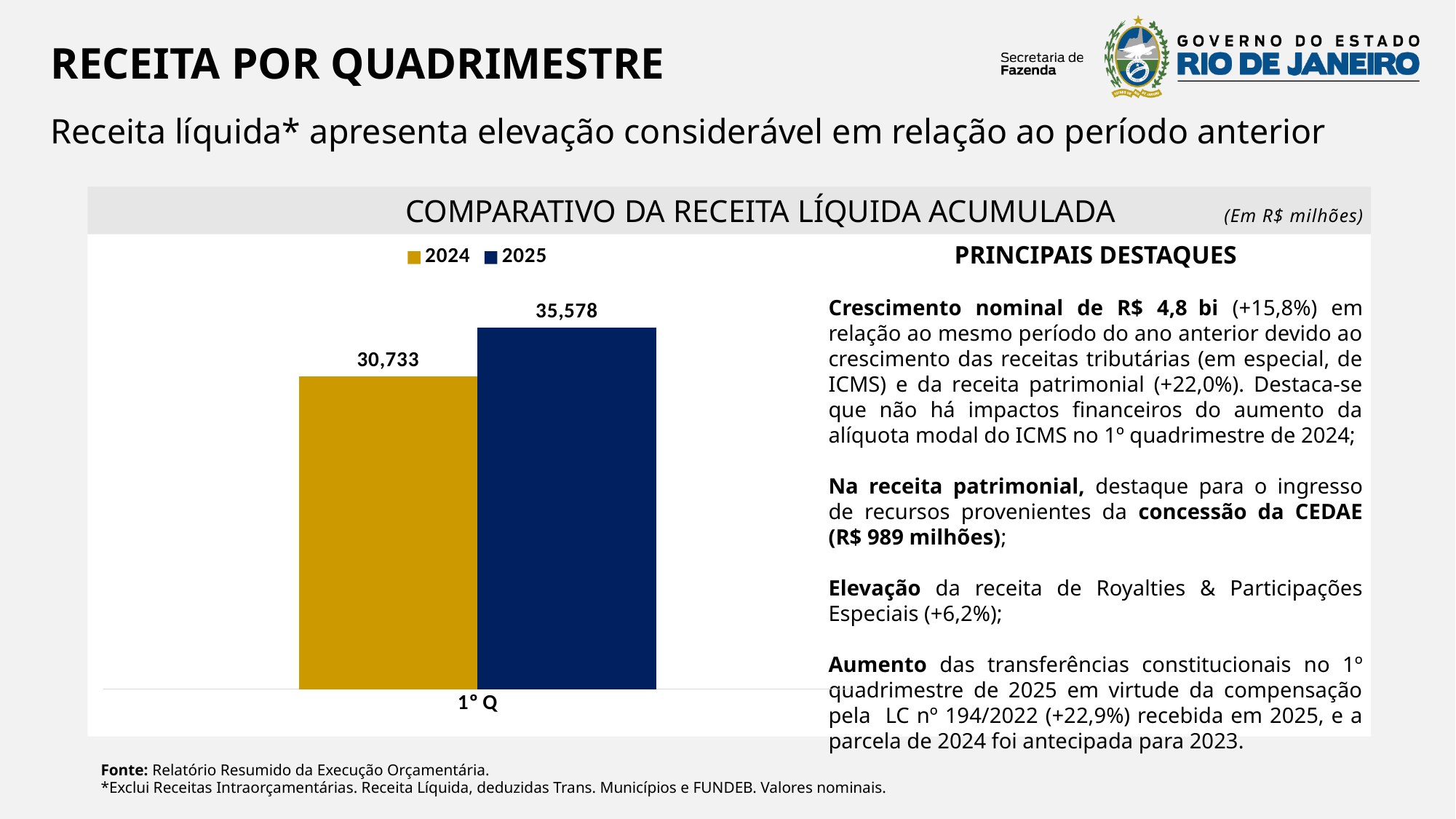
What is the difference between the 2025 and 2024 values for 1° Q? 4,845 What is the label of the category on the x axis? 1° Q In what unit are the chart values expressed? Em R$ milhões How many series does the chart legend list? 2 What is the value for 2025 in the 1° Q bar chart? 35,578 What kind of chart is shown on the slide? Bar chart How many categories are shown on the x axis of the chart? 1 What is the title of the chart? COMPARATIVO DA RECEITA LÍQUIDA ACUMULADA Which series shows the lowest value in the chart? 2024 Which series has the higher value for 1° Q, 2024 or 2025? 2025 What is the value for 2024 in the 1° Q bar chart? 30,733